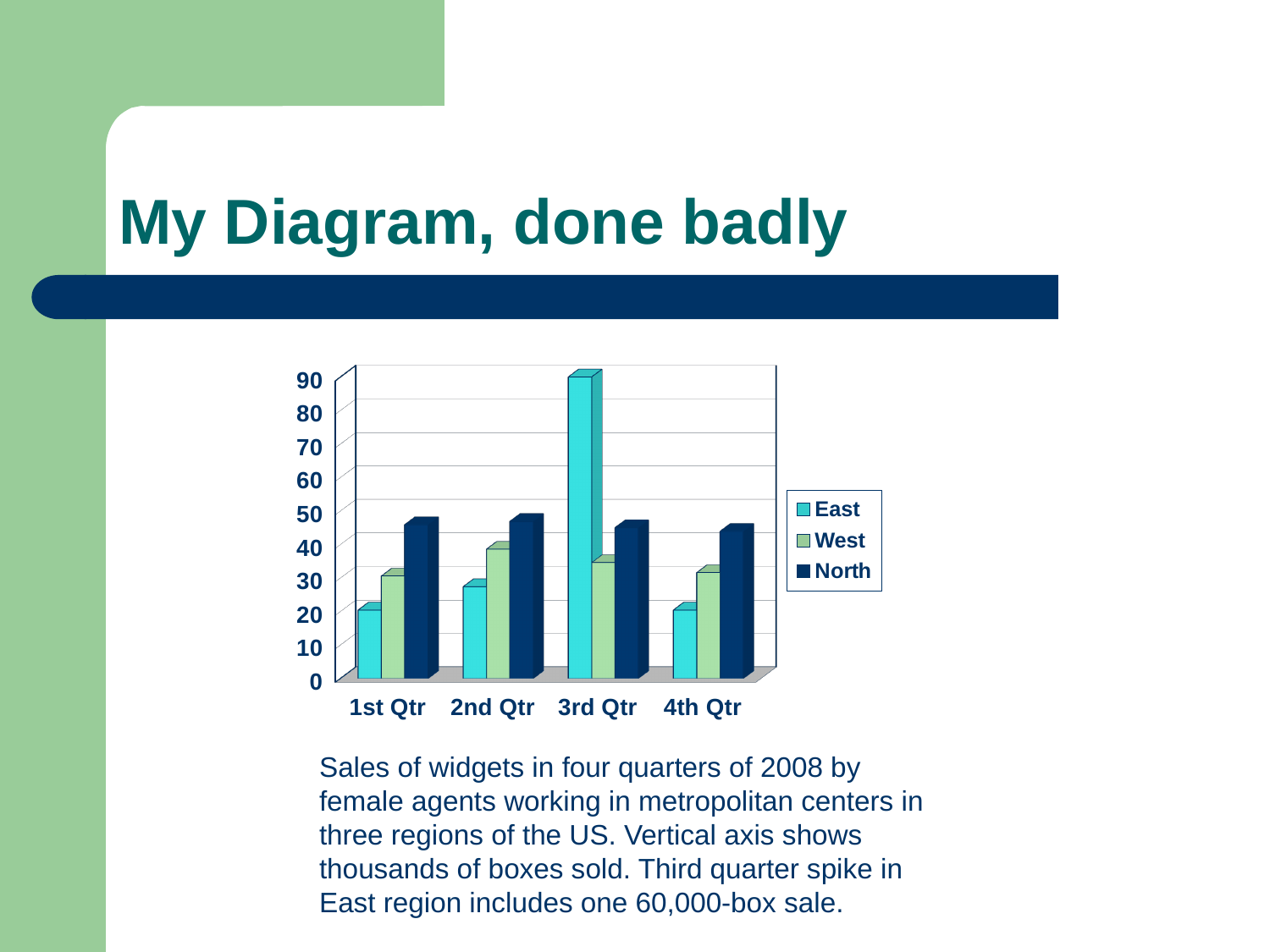
Which series has the lowest value in 4th Qtr? East In which quarter is the East series highest? 3rd Qtr Is the West value for 2nd Qtr greater or less than 30? greater In 1st Qtr, which is larger, the North value or the East value? North How many series does the chart's legend list? 3 What kind of chart is shown on the slide? bar chart What is the title of the slide containing the chart? My Diagram, done badly Is the East value for 1st Qtr greater or less than 30? less In 2nd Qtr, which is larger, the East value or the West value? West What are the entries in the chart's legend? East, West, North Is the East value for 3rd Qtr greater or less than 80? greater How many quarters are shown on the x axis of the chart? 4